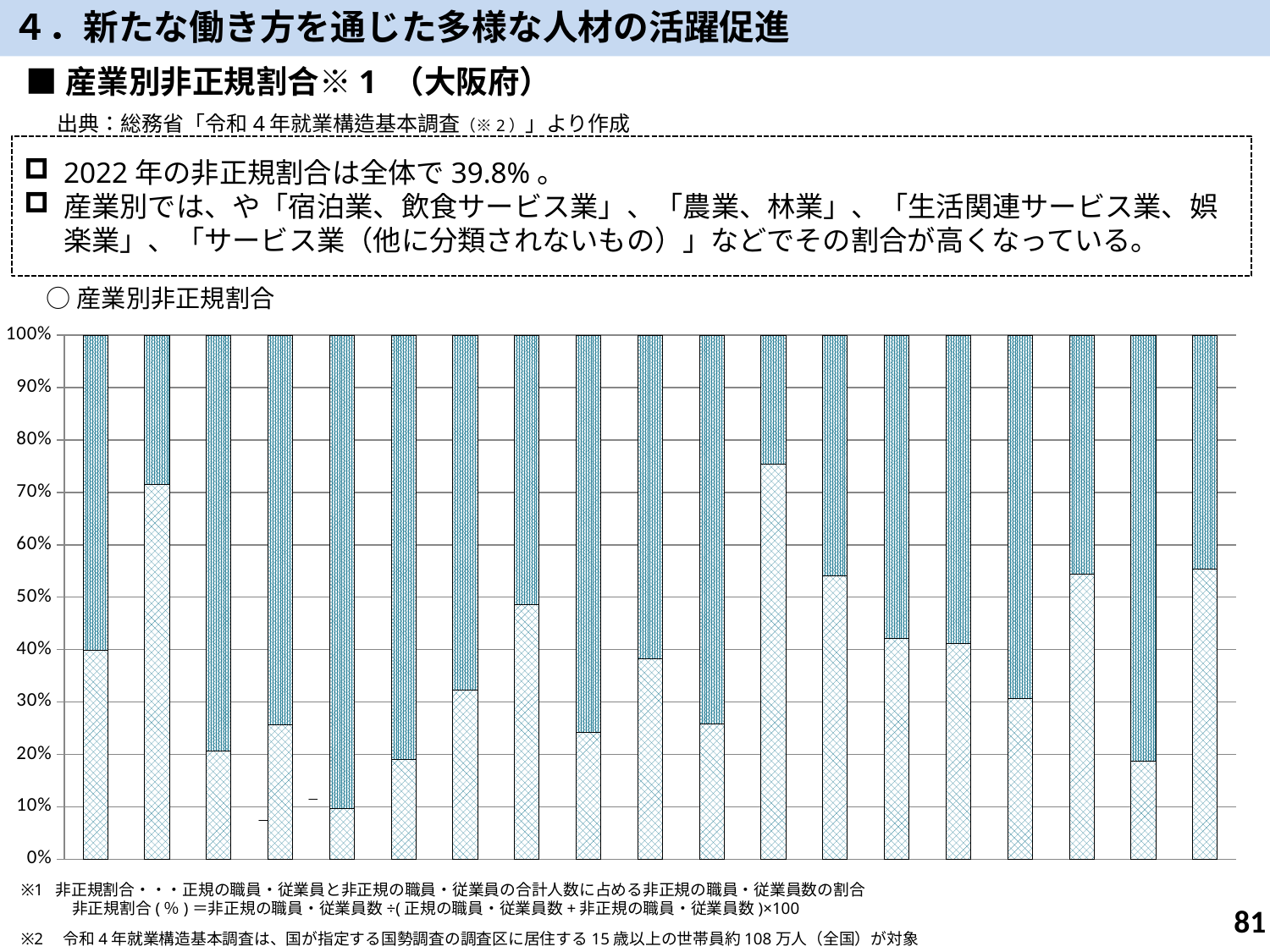
What is the highest value shown on the chart's vertical axis? 100% Which bar has the smallest lower (cross-hatched) segment? the fifth bar from the left Is the lower (cross-hatched) segment of the rightmost bar greater or less than 40%? greater Is the lower (cross-hatched) segment of the fifth bar from the left greater or less than 20%? less Is the lower (cross-hatched) segment of the seventh bar from the left greater or less than 40%? less Which has the larger lower (cross-hatched) segment: the leftmost bar or the third bar from the left? the leftmost bar What kind of chart is shown on the slide? bar chart How many bars (categories) are plotted in the chart? 19 What is the title printed above the chart? 産業別非正規割合